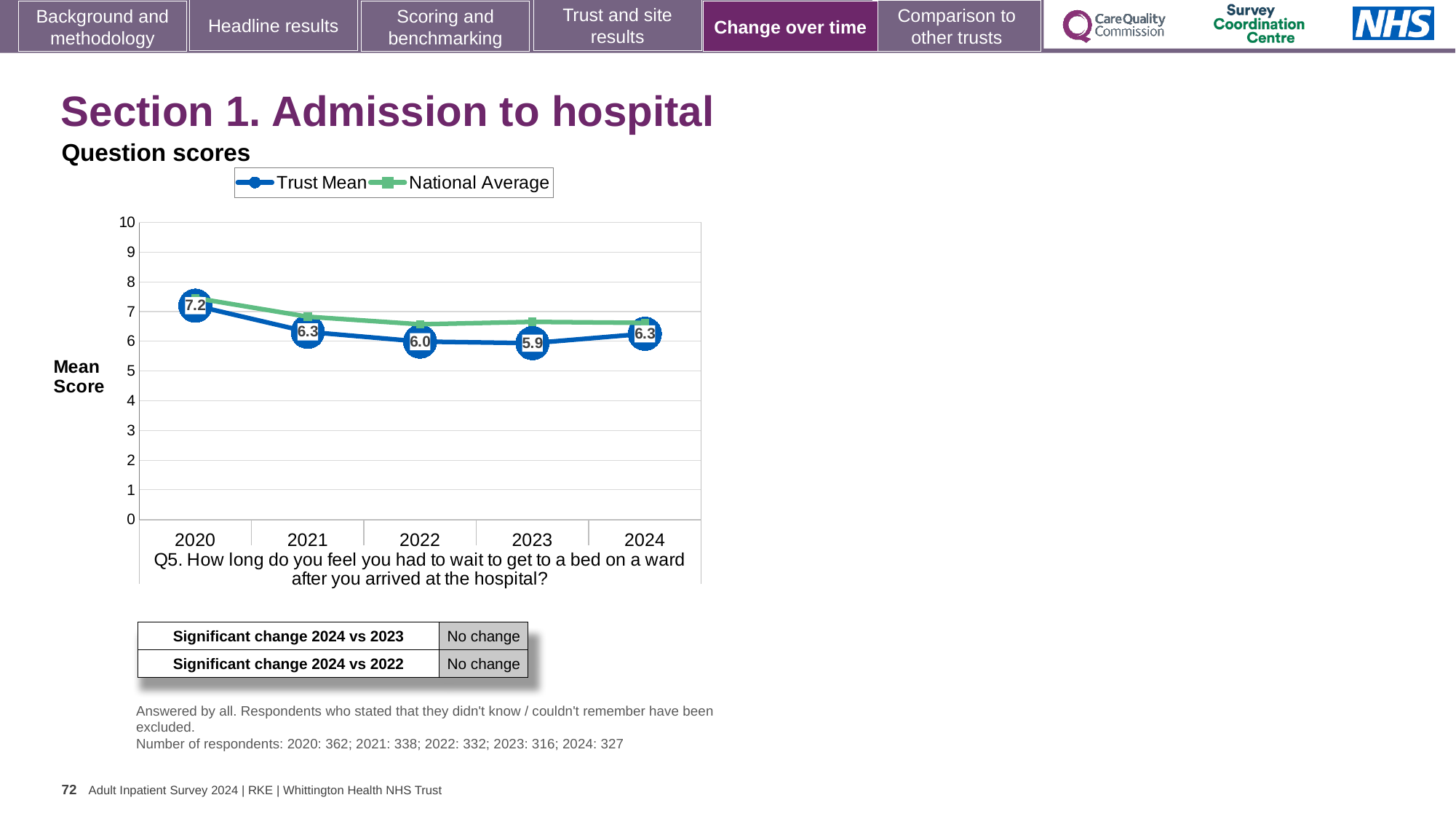
Is the National Average value for 2020 greater or less than 7? greater Is the National Average value for 2022 greater or less than 7? less What kind of chart is shown on the slide? Line chart What is the difference between the Trust Mean score in 2020 and in 2022? 1.2 What is the Trust Mean score for 2023? 5.9 In which year is the Trust Mean score highest? 2020 How many series does the legend list? 2 How many years are plotted on the x axis? 5 What is the Trust Mean score for 2020? 7.2 What is the Trust Mean score for 2024? 6.3 Which is larger, the Trust Mean score in 2021 or in 2023? 2021 In which year is the Trust Mean score lowest? 2023